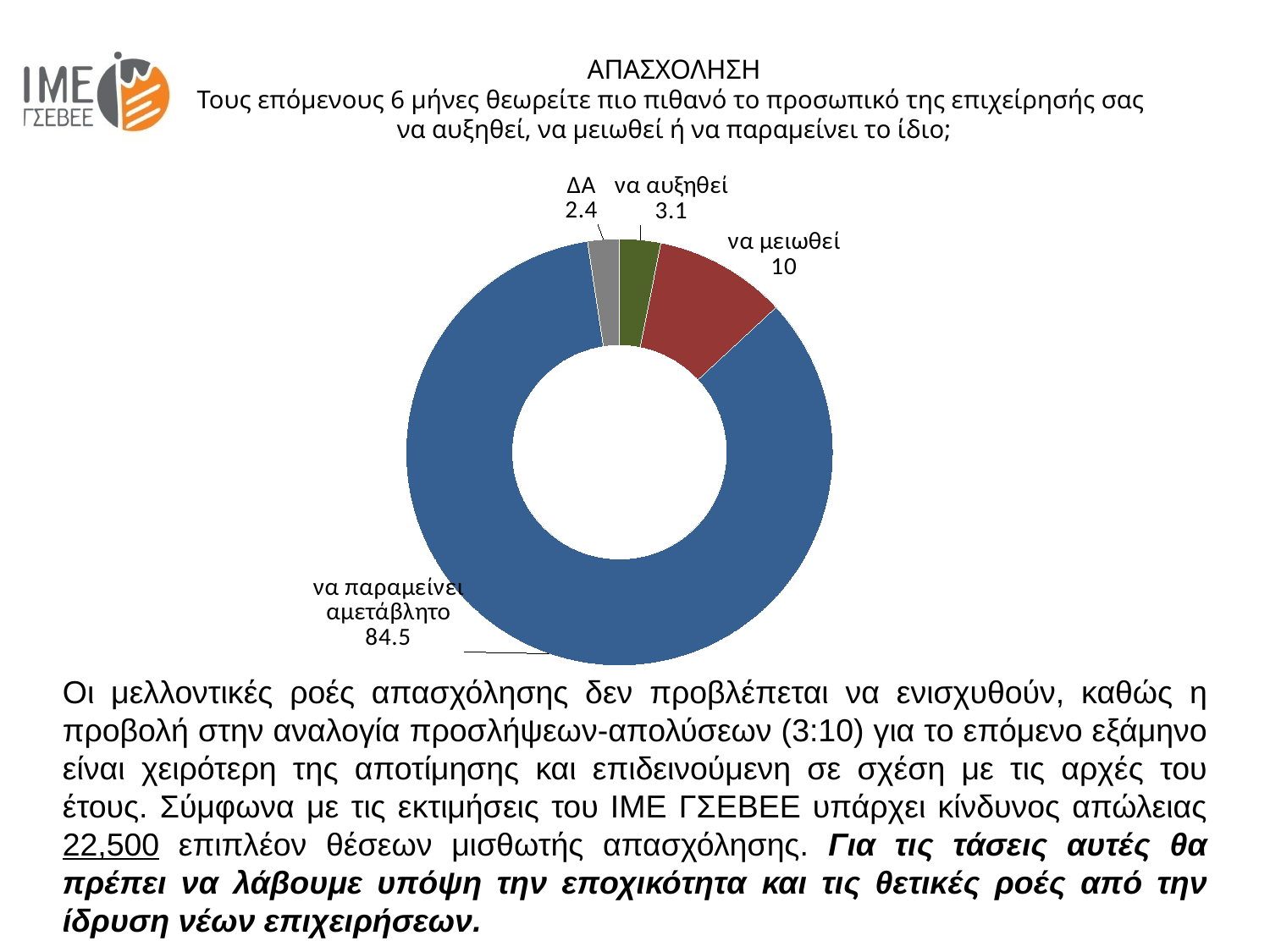
What value is shown for "ΔΑ"? 2.4 What value is shown for "να αυξηθεί"? 3.1 What value is shown for "να παραμείνει αμετάβλητο"? 84.5 What value is shown for "να μειωθεί"? 10 What is the difference between the values for "να μειωθεί" and "να αυξηθεί"? 6.9 Which is larger, the value for "να μειωθεί" or the value for "να αυξηθεί"? να μειωθεί What kind of chart is shown on the slide? doughnut chart How many categories does the chart show? 4 What is the difference between the values for "να παραμείνει αμετάβλητο" and "να μειωθεί"? 74.5 Which category has the largest slice? να παραμείνει αμετάβλητο Which category has the smallest slice? ΔΑ What is the title of the chart? ΑΠΑΣΧΟΛΗΣΗ